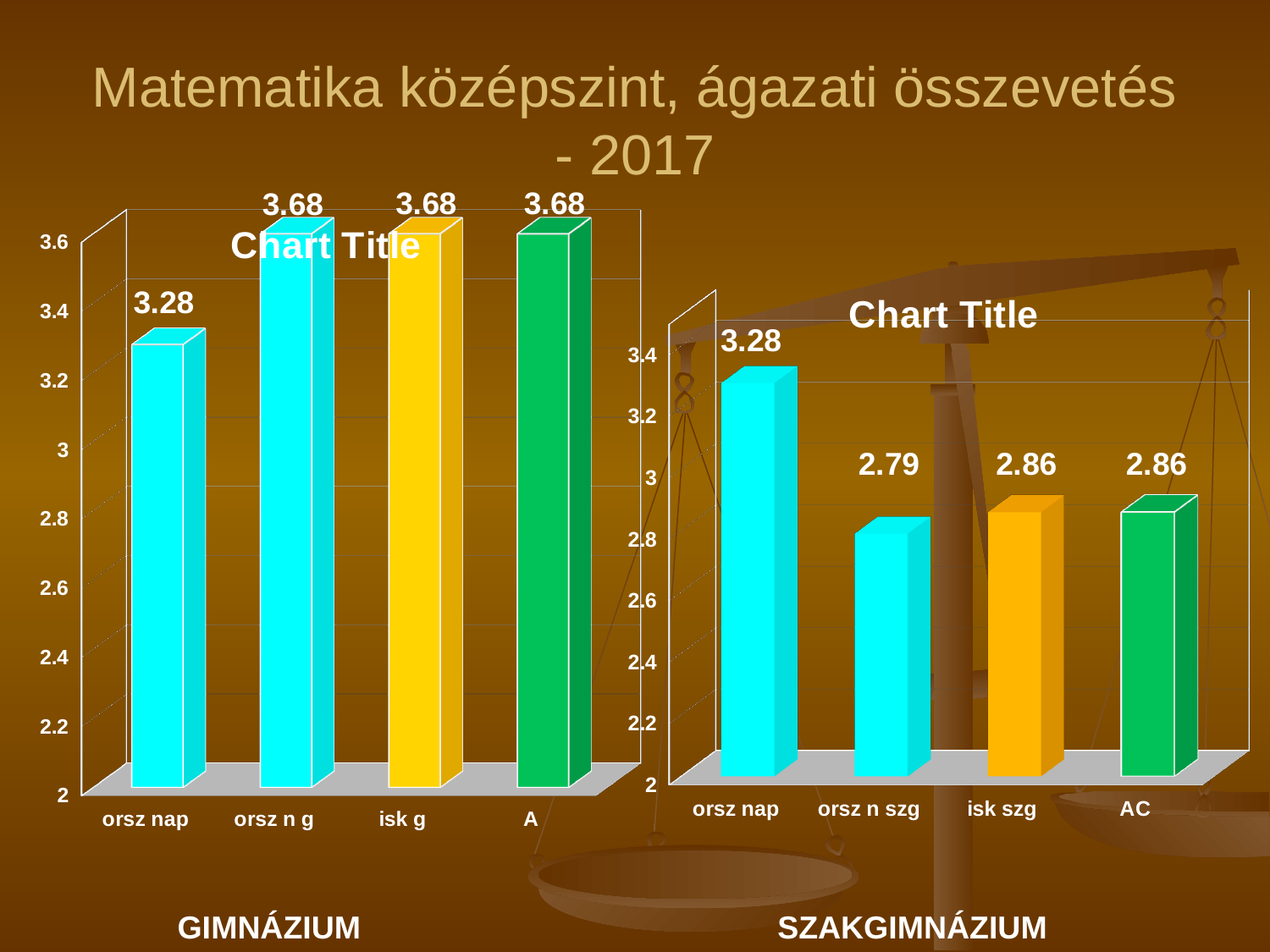
In the right chart (SZAKGIMNÁZIUM), which category has the highest value? orsz nap In the right chart (SZAKGIMNÁZIUM), which is larger, the value for orsz nap or the value for orsz n szg? orsz nap What kind of chart is the right chart (SZAKGIMNÁZIUM)? bar chart In the left chart (GIMNÁZIUM), which category has the lowest value? orsz nap In the right chart (SZAKGIMNÁZIUM), what is the difference between the values for orsz nap and isk szg? 0.42 In the right chart (SZAKGIMNÁZIUM), what is the value for orsz n szg? 2.79 In the left chart (GIMNÁZIUM), what is the difference between the values for orsz n g and orsz nap? 0.4 In the left chart (GIMNÁZIUM), what is the value for isk g? 3.68 In the right chart (SZAKGIMNÁZIUM), which category has the lowest value? orsz n szg In the left chart (GIMNÁZIUM), what is the value for orsz nap? 3.28 How many categories are shown in the left chart (GIMNÁZIUM)? 4 In the right chart (SZAKGIMNÁZIUM), what is the value for AC? 2.86